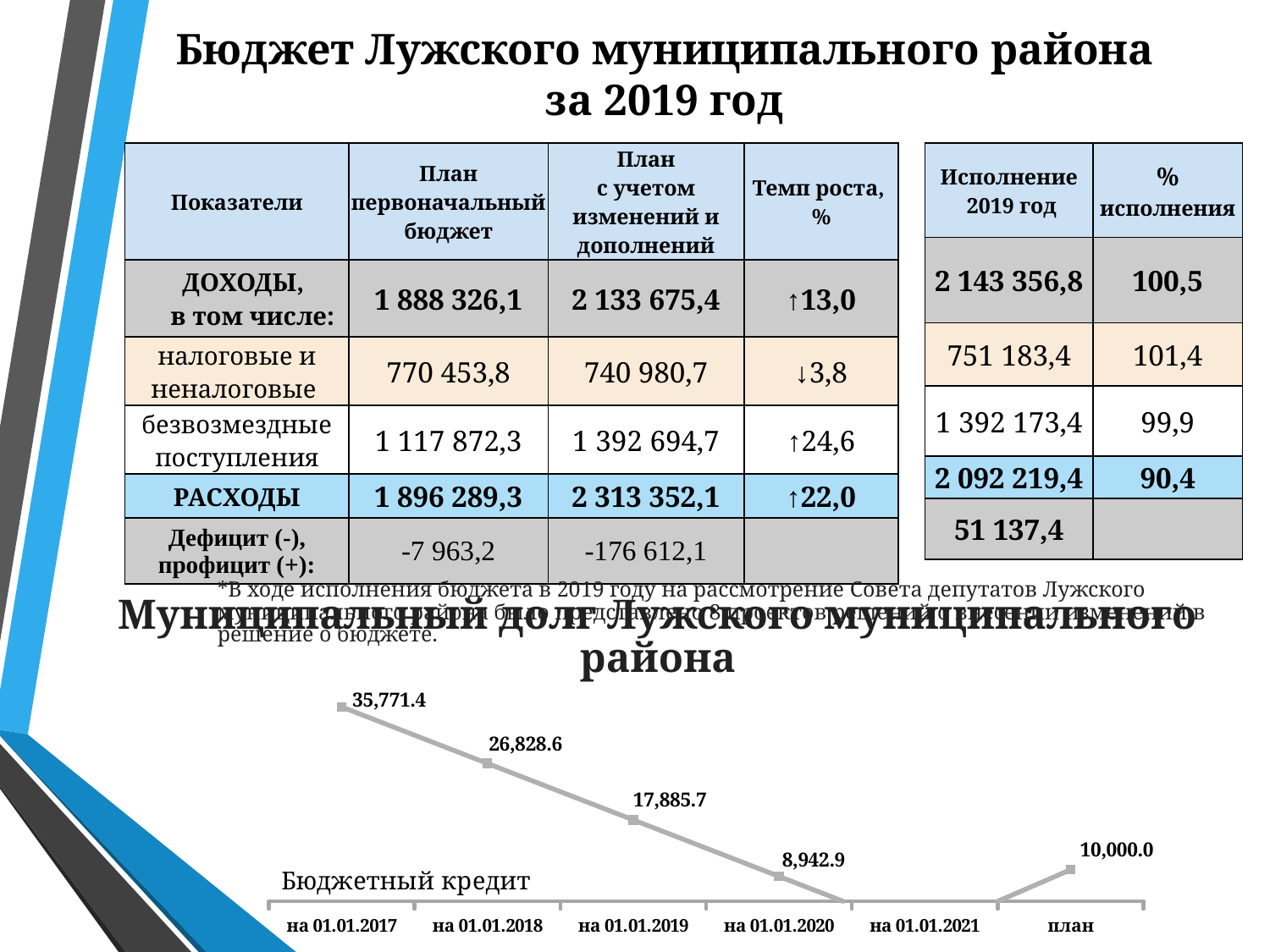
How many series does the chart show? 1 Which x-axis category has the highest value in the chart? на 01.01.2017 What is the value of Бюджетный кредит for план? 10,000.0 How many points are plotted along the x axis of the chart? 6 What is the title of the chart at the bottom of the slide? Муниципальный долг Лужского муниципального района What is the value of Бюджетный кредит на 01.01.2020? 8,942.9 What kind of chart is shown at the bottom of the slide? line chart What is the value of Бюджетный кредит на 01.01.2018? 26,828.6 What is the name of the series plotted in the chart? Бюджетный кредит Does the value of Бюджетный кредит rise or fall from 01.01.2017 to 01.01.2020? fall What is the difference between the values на 01.01.2017 and на 01.01.2018? 8,942.8 What is the value of Бюджетный кредит на 01.01.2017? 35,771.4